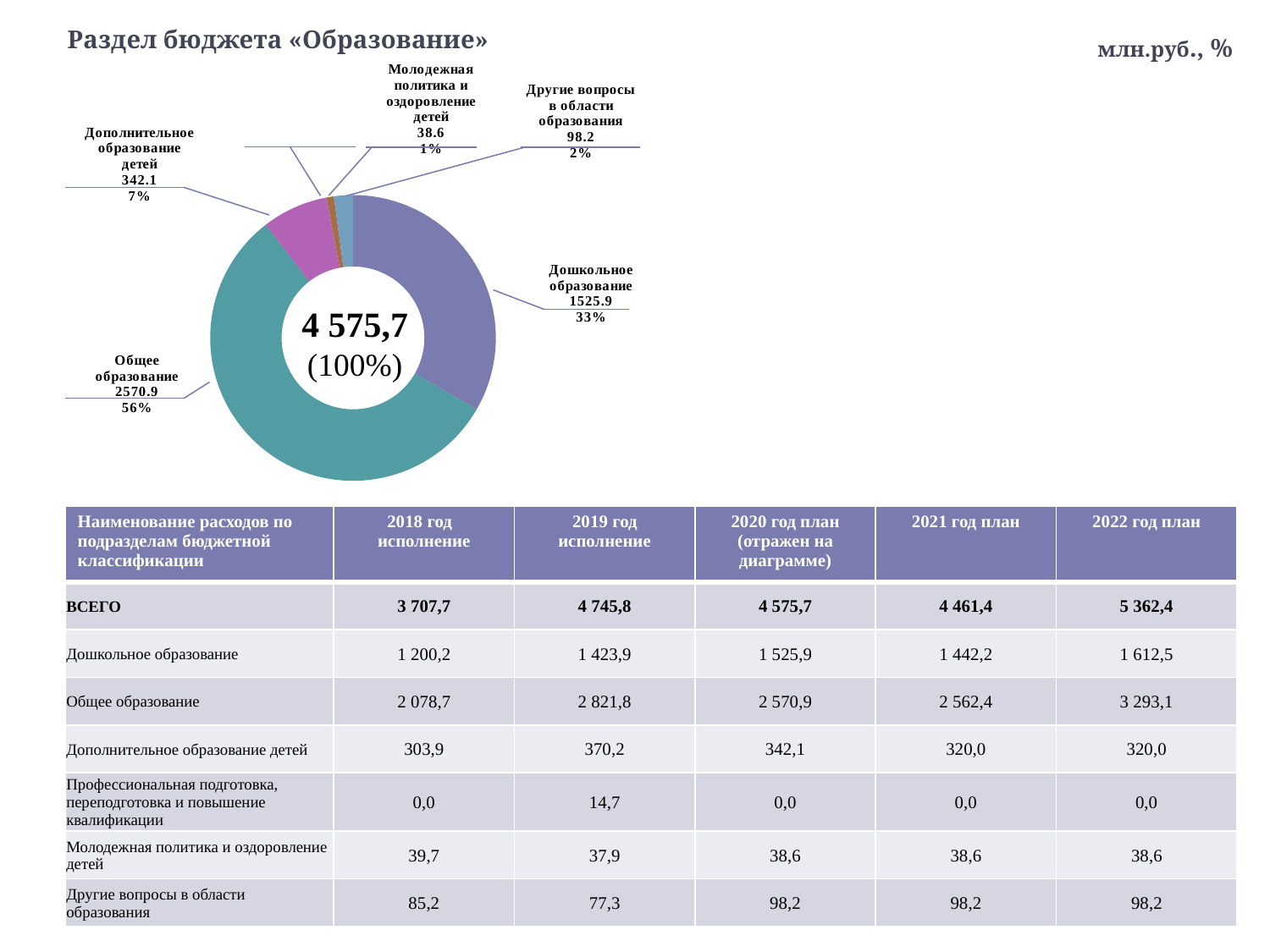
What value is shown for Общее образование on the chart? 2570.9 Which category has the largest slice in the chart? Общее образование What value is shown for Дополнительное образование детей on the chart? 342.1 What total value is printed in the centre of the donut chart? 4 575,7 (100%) Which is larger on the chart: Дополнительное образование детей or Другие вопросы в области образования? Дополнительное образование детей Which labelled category has the smallest slice in the chart? Молодежная политика и оздоровление детей What share of the chart does Другие вопросы в области образования represent? 2% What value is shown for Дошкольное образование on the chart? 1525.9 What is the difference between the values for Общее образование and Дошкольное образование on the chart? 1045.0 What value is shown for Молодежная политика и оздоровление детей on the chart? 38.6 What share of the chart does Общее образование represent? 56% What kind of chart is shown on the slide? Donut (pie) chart